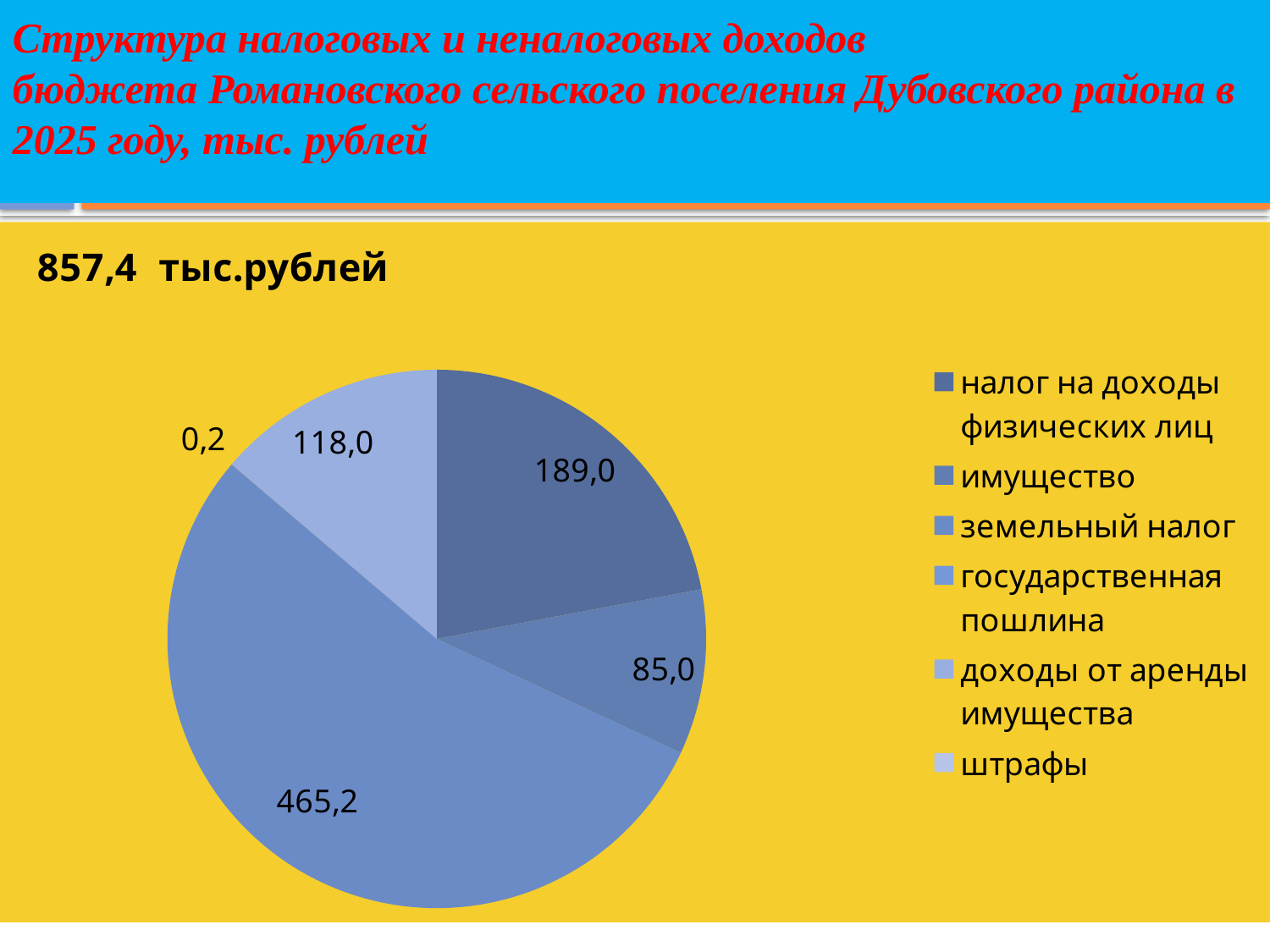
What total amount in тыс. рублей is stated on the slide for the revenues shown in the pie? 857,4 What is the value for доходы от аренды имущества? 118,0 What kind of chart is shown on the slide? pie chart Which category has the largest slice of the pie? земельный налог Which year does the chart title refer to? 2025 Which is larger, налог на доходы физических лиц or доходы от аренды имущества? налог на доходы физических лиц What is the value for имущество? 85,0 What is the value for государственная пошлина? 0,2 What is the value for налог на доходы физических лиц? 189,0 What is the value for земельный налог? 465,2 What is the difference between the values for земельный налог and налог на доходы физических лиц? 276,2 How many categories does the legend list? 6